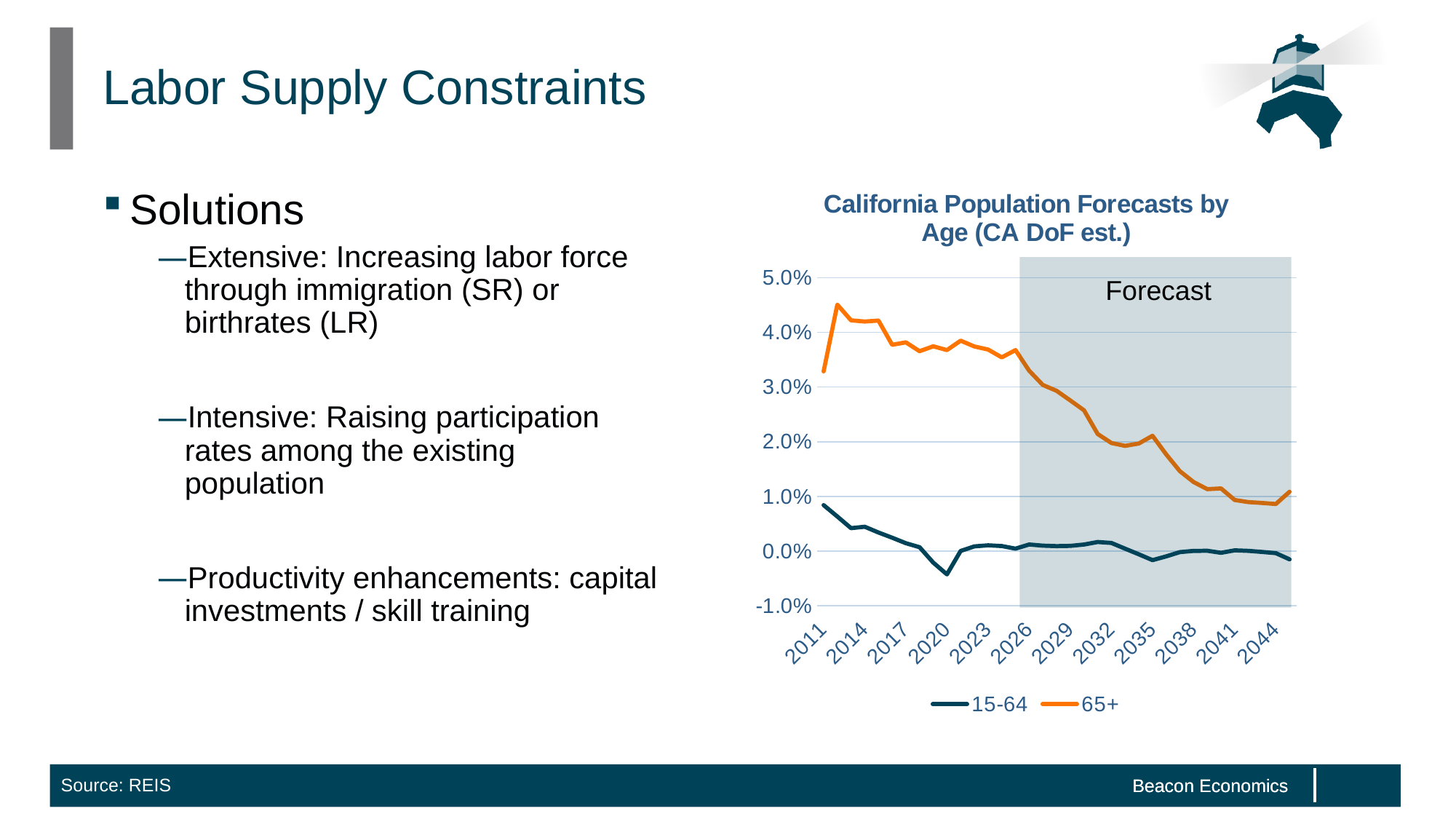
How many series does the legend list? 2 Which series has the higher value in 2029, 15-64 or 65+? 65+ Is the value for 15-64 in 2020 greater or less than 0.0%? less Does the 15-64 series rise or fall from 2011 to 2020? fall How many year labels are shown on the x axis? 12 What does the shaded region on the right side of the chart represent? Forecast What kind of chart is shown on the slide? line chart Does the 65+ series rise or fall overall from 2014 to 2044? fall Is the value for 65+ in 2011 greater or less than 3.0%? greater What is the title of the chart? California Population Forecasts by Age (CA DoF est.) Is the value for 65+ in 2029 greater or less than 2.0%? greater